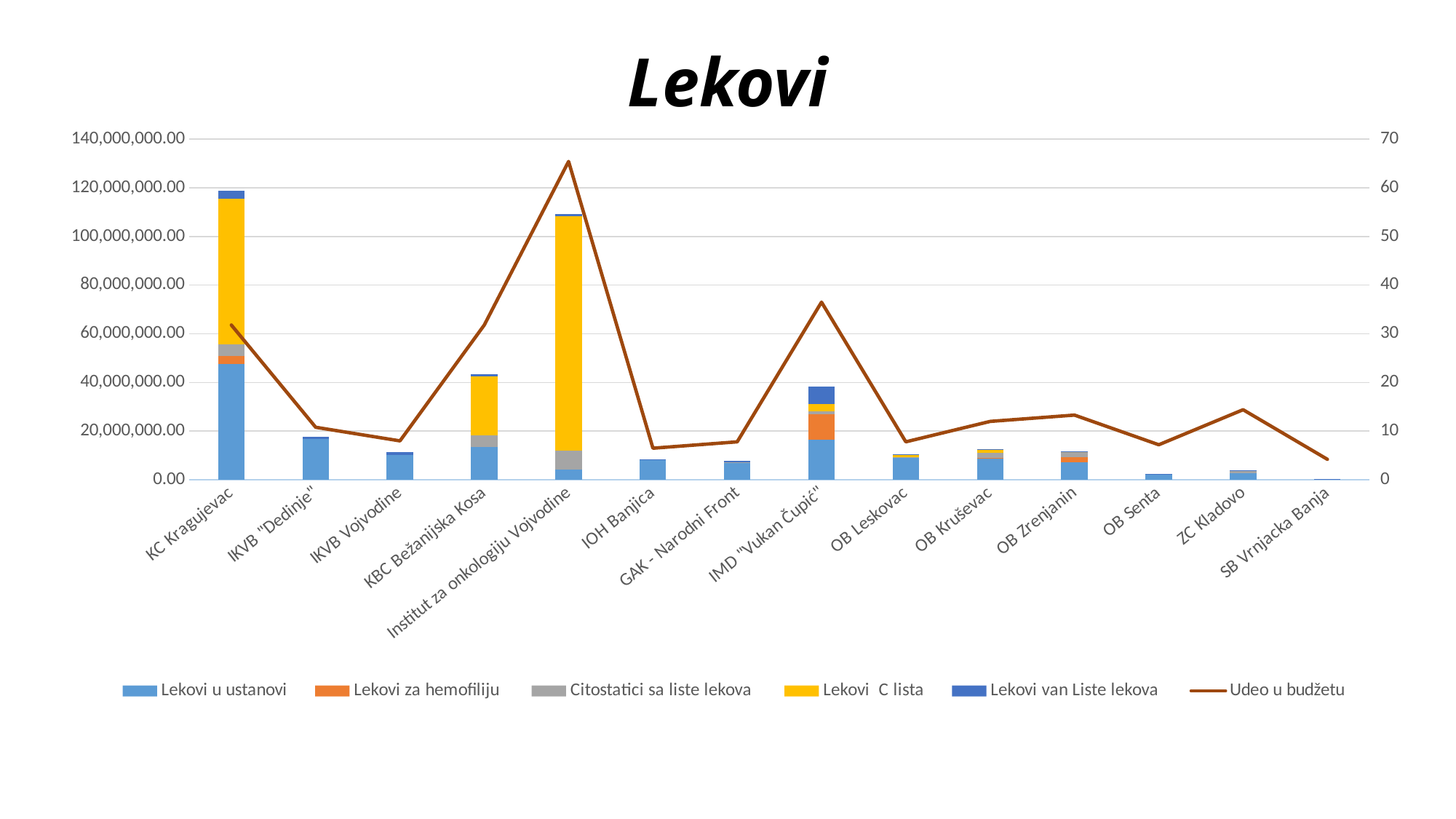
Is the Udeo u budžetu value for IMD "Vukan Čupić" greater or less than 30? greater How many institutions (categories) are shown on the x axis? 14 Is the total stacked bar for IKVB "Dedinje" greater or less than 20,000,000.00? less What kind of chart is shown on the slide? A combination chart of stacked bars and a line Which institution has the highest value on the Udeo u budžetu line? Institut za onkologiju Vojvodine What is the title of the chart? Lekovi Which institution has the lowest value on the Udeo u budžetu line? SB Vrnjacka Banja Which institution has the tallest stacked bar? KC Kragujevac How many entries does the legend list? 7 Is the total stacked bar for KC Kragujevac greater or less than 100,000,000.00? greater Which has the larger total stacked bar, KBC Bežanijska Kosa or OB Leskovac? KBC Bežanijska Kosa